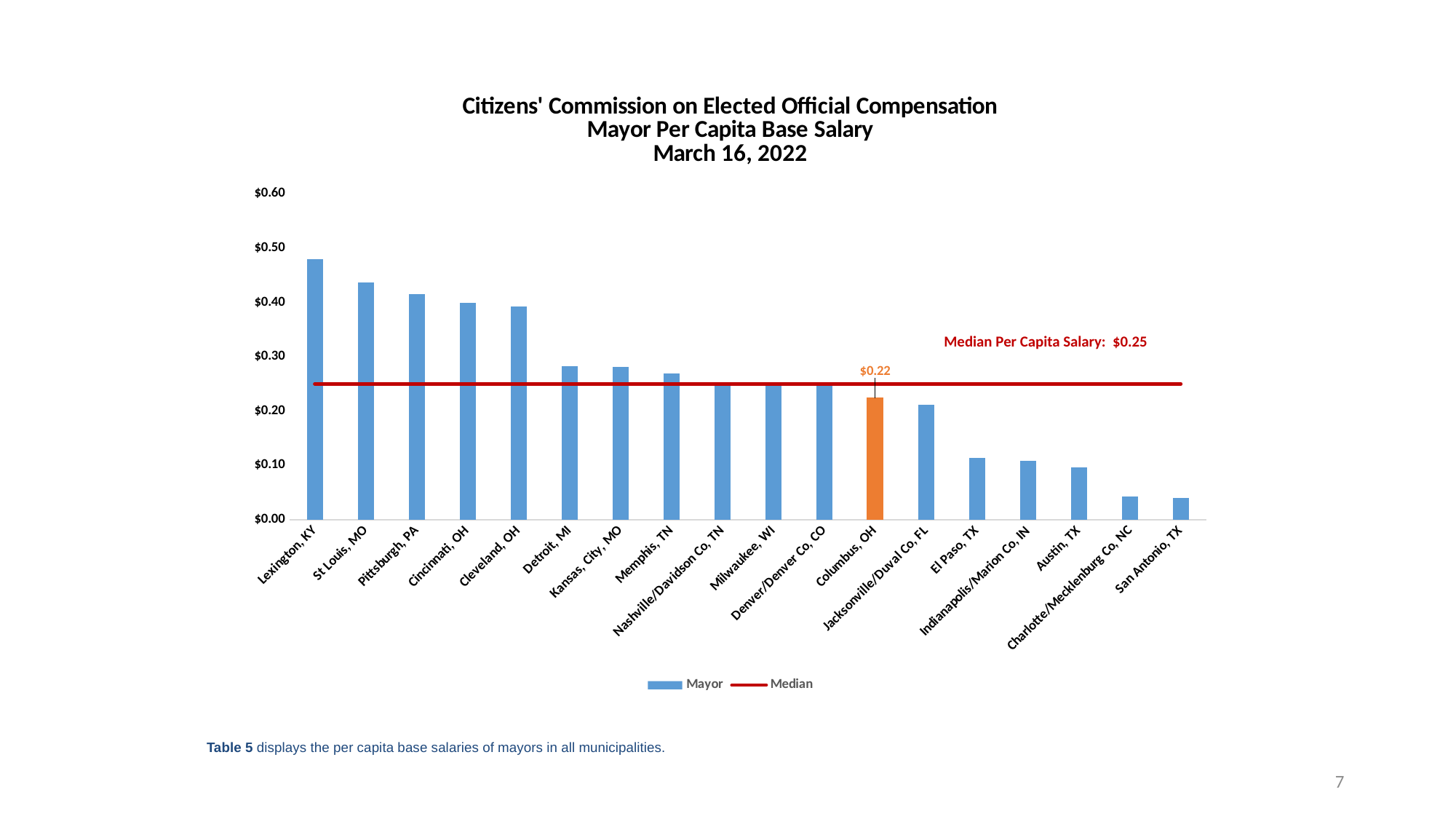
Which municipality has the highest mayor per capita base salary? Lexington, KY Which bar is highlighted in orange on the chart? Columbus, OH What type of chart is shown on the slide? bar chart How many municipalities are shown on the x axis? 18 What is the median per capita salary shown on the chart? $0.25 Is the value for Detroit, MI greater or less than $0.30? less How many series does the legend list? 2 Which is larger, the value for Lexington, KY or the value for St Louis, MO? Lexington, KY What is the per capita base salary value labelled for Columbus, OH? $0.22 Do the bar values rise or fall from left to right along the x axis? fall Is the value for Lexington, KY greater or less than $0.40? greater